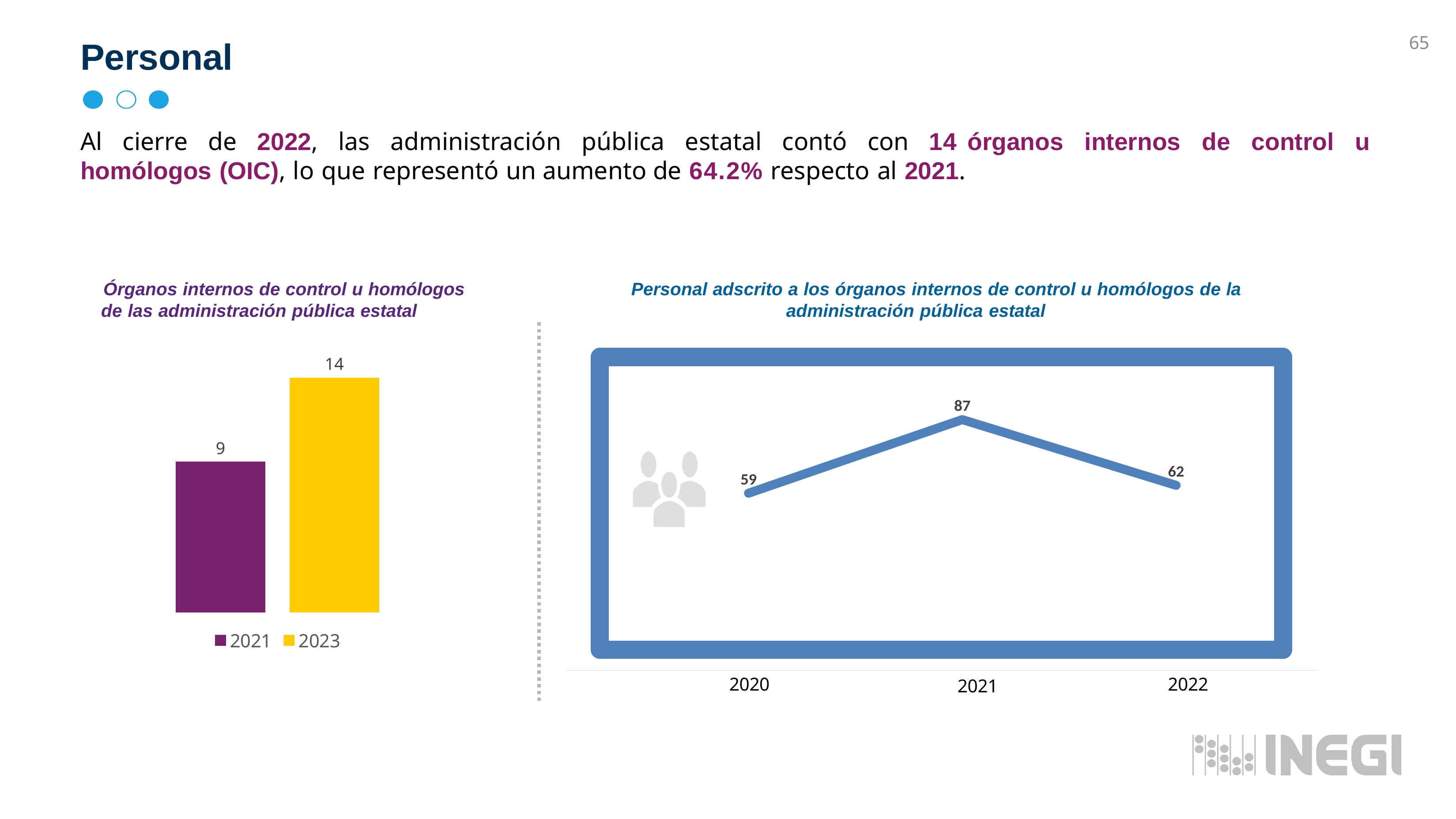
In the right chart (Personal adscrito a los órganos internos de control u homólogos), what is the value for 2021? 87 In the left chart (Órganos internos de control u homólogos), which series has the higher value, 2021 or 2023? 2023 How many series does the legend of the left chart (Órganos internos de control u homólogos) list? 2 In the left chart (Órganos internos de control u homólogos de las administración pública estatal), what is the value for 2023? 14 In the left chart (Órganos internos de control u homólogos), what is the difference between the 2023 and 2021 values? 5 In the left chart (Órganos internos de control u homólogos de las administración pública estatal), what is the value for 2021? 9 What kind of chart is the left chart (Órganos internos de control u homólogos)? Bar chart In the right chart (Personal adscrito a los órganos internos de control u homólogos), what is the value for 2020? 59 In the left chart (Órganos internos de control u homólogos), what colour is the bar for 2023? Yellow In the right chart (Personal adscrito a los órganos internos de control u homólogos), what is the difference between the 2021 and 2022 values? 25 In the right chart (Personal adscrito a los órganos internos de control u homólogos), which year has the lowest value? 2020 In the right chart (Personal adscrito a los órganos internos de control u homólogos), which year has the highest value? 2021